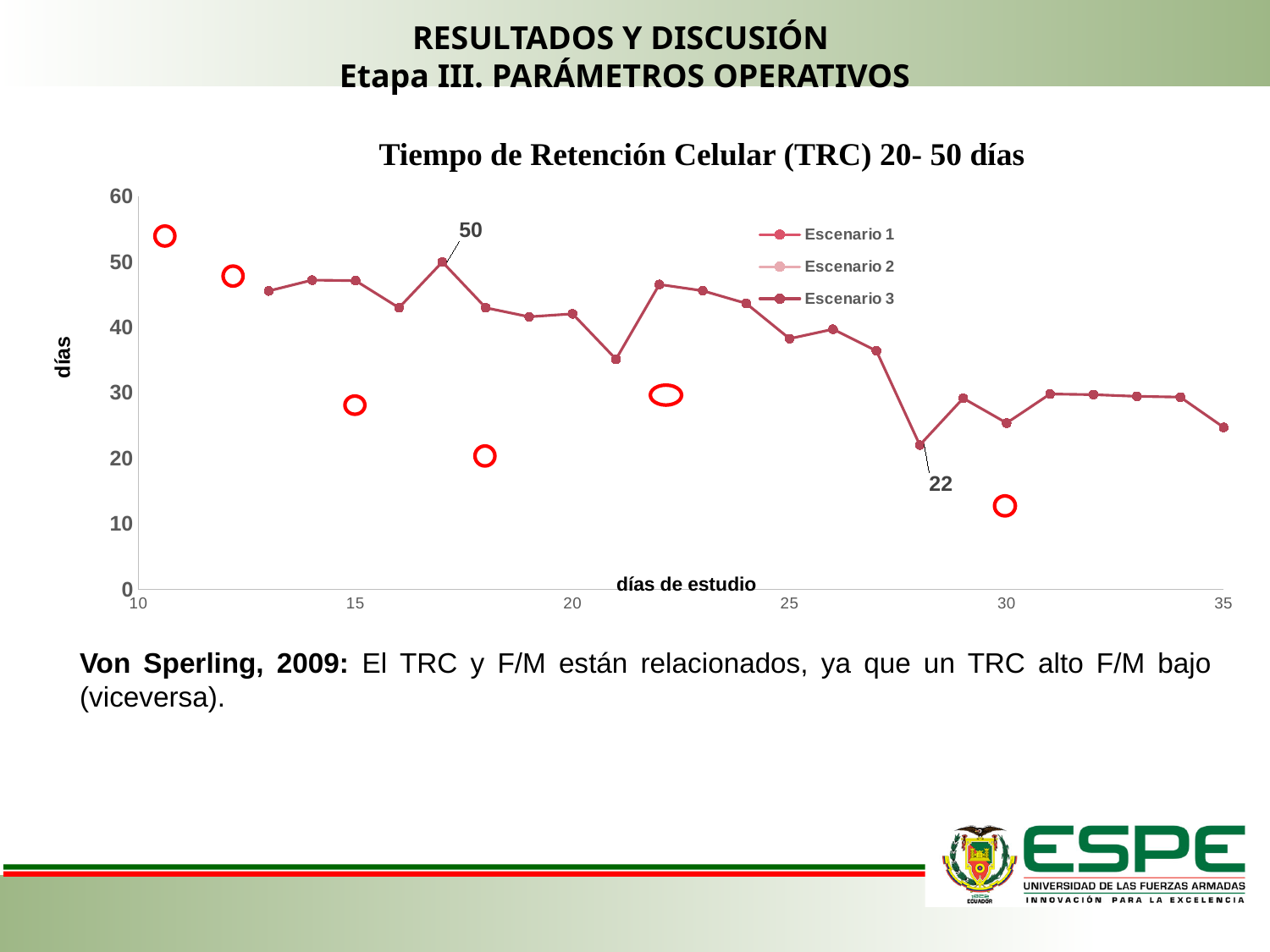
What value is labelled on the line at day 17 of the study? 50 How many series does the legend list? 3 What kind of chart is shown on the slide? line chart What is the title of the chart? Tiempo de Retención Celular (TRC) 20- 50 días At which day of the study does the line reach its highest value? 17 What value is labelled on the line at day 28 of the study? 22 Is the value at day 13 greater or less than 40? greater What is the difference between the labelled values 50 and 22 on the chart? 28 Overall, do the values rise or fall as the days of study increase? fall What is the label of the vertical axis? días At which day of the study does the line reach its lowest value? 28 Is the value at day 21 greater or less than 40? less